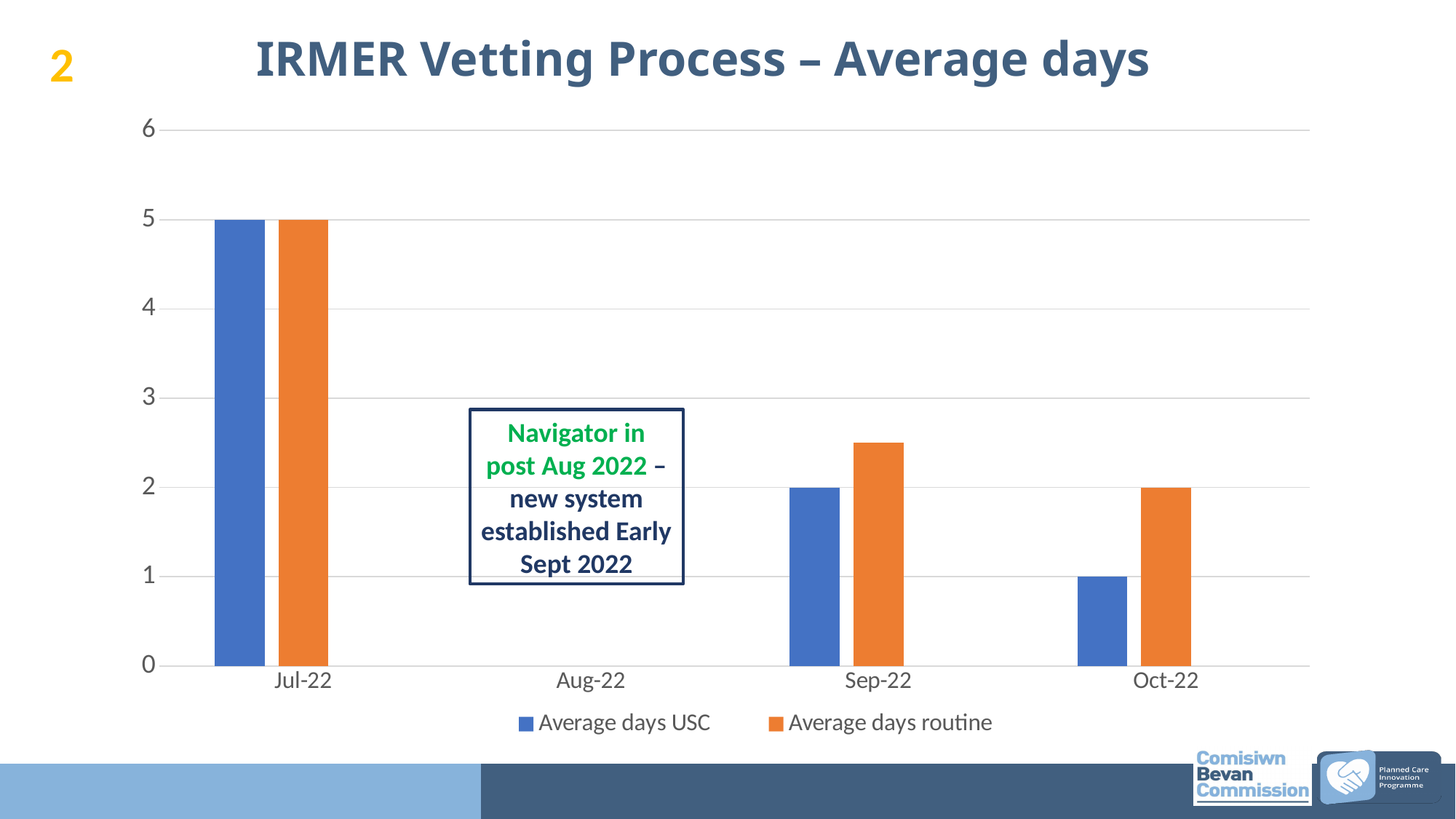
What is the value for Average days routine in Oct-22? 2 Is the value for Average days routine in Sep-22 greater or less than 3? less What kind of chart is shown on the slide? Bar chart In Sep-22, which is larger: Average days USC or Average days routine? Average days routine What is the difference between Average days USC in Jul-22 and Average days USC in Oct-22? 4 Which month has the highest value for Average days USC? Jul-22 What is the value for Average days USC in Oct-22? 1 Which month has the lowest value for Average days USC? Oct-22 How many series does the legend list? 2 Does Average days USC rise or fall from Jul-22 to Oct-22? Fall What is the value for Average days USC in Jul-22? 5 How many months are shown on the x axis? 4